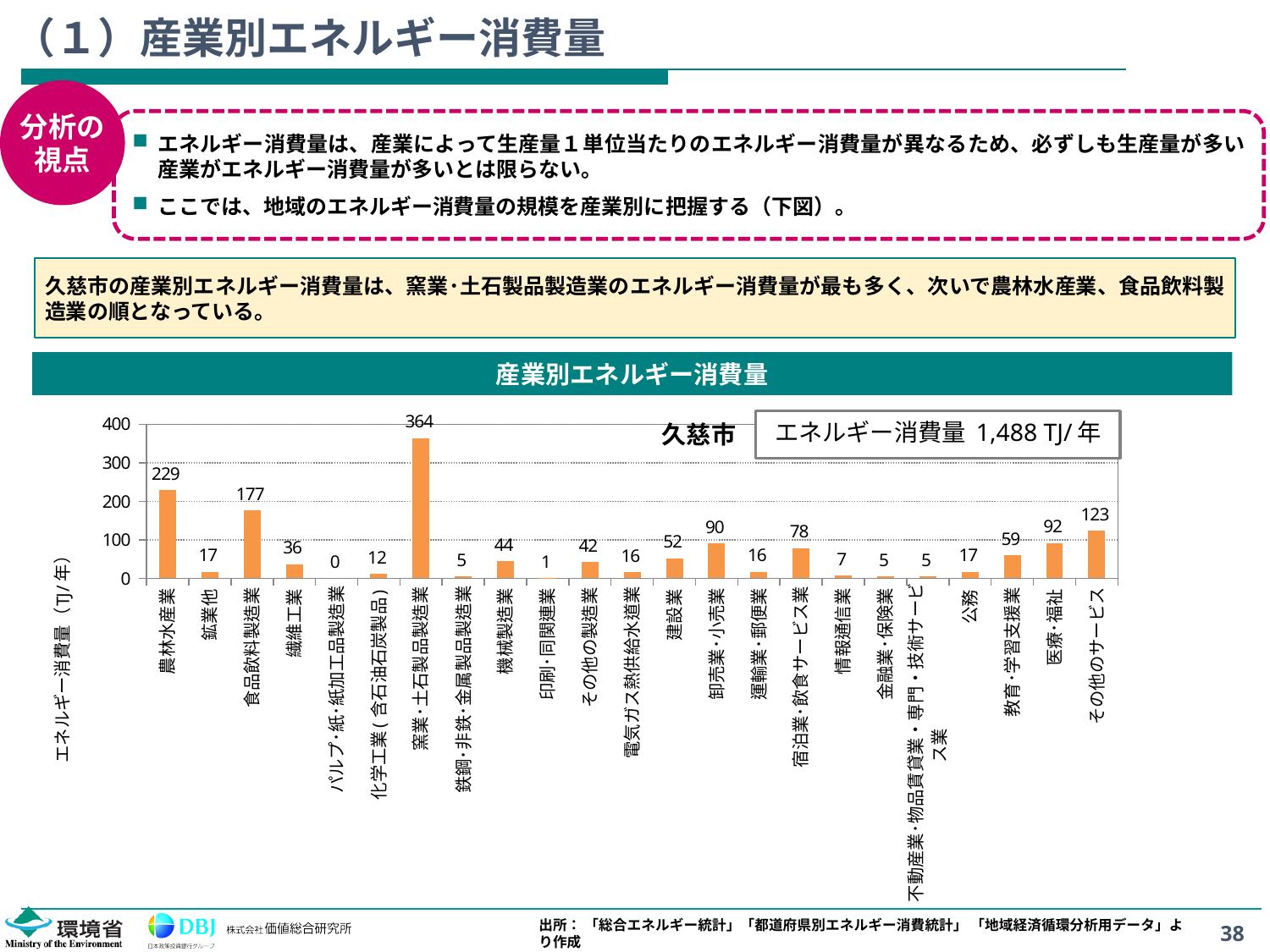
Which is larger, the value for 卸売業・小売業 or the value for 宿泊業・飲食サービス業? 卸売業・小売業 What total energy consumption is stated in the box on the chart? 1,488 TJ/年 Is the value for その他のサービス greater or less than 100? greater What is the value shown for 医療・福祉? 92 Which industry has the highest energy consumption in the chart? 窯業・土石製品製造業 What is the unit shown on the vertical axis label of the chart? TJ/年 What is the energy consumption value for 農林水産業? 229 What is the difference between the values for 農林水産業 and 食品飲料製造業? 52 What is the energy consumption value for 窯業・土石製品製造業? 364 What kind of chart is used to show 産業別エネルギー消費量? bar chart Which industry has the lowest energy consumption in the chart? パルプ・紙・紙加工品製造業 How many industry categories are plotted in the chart? 23